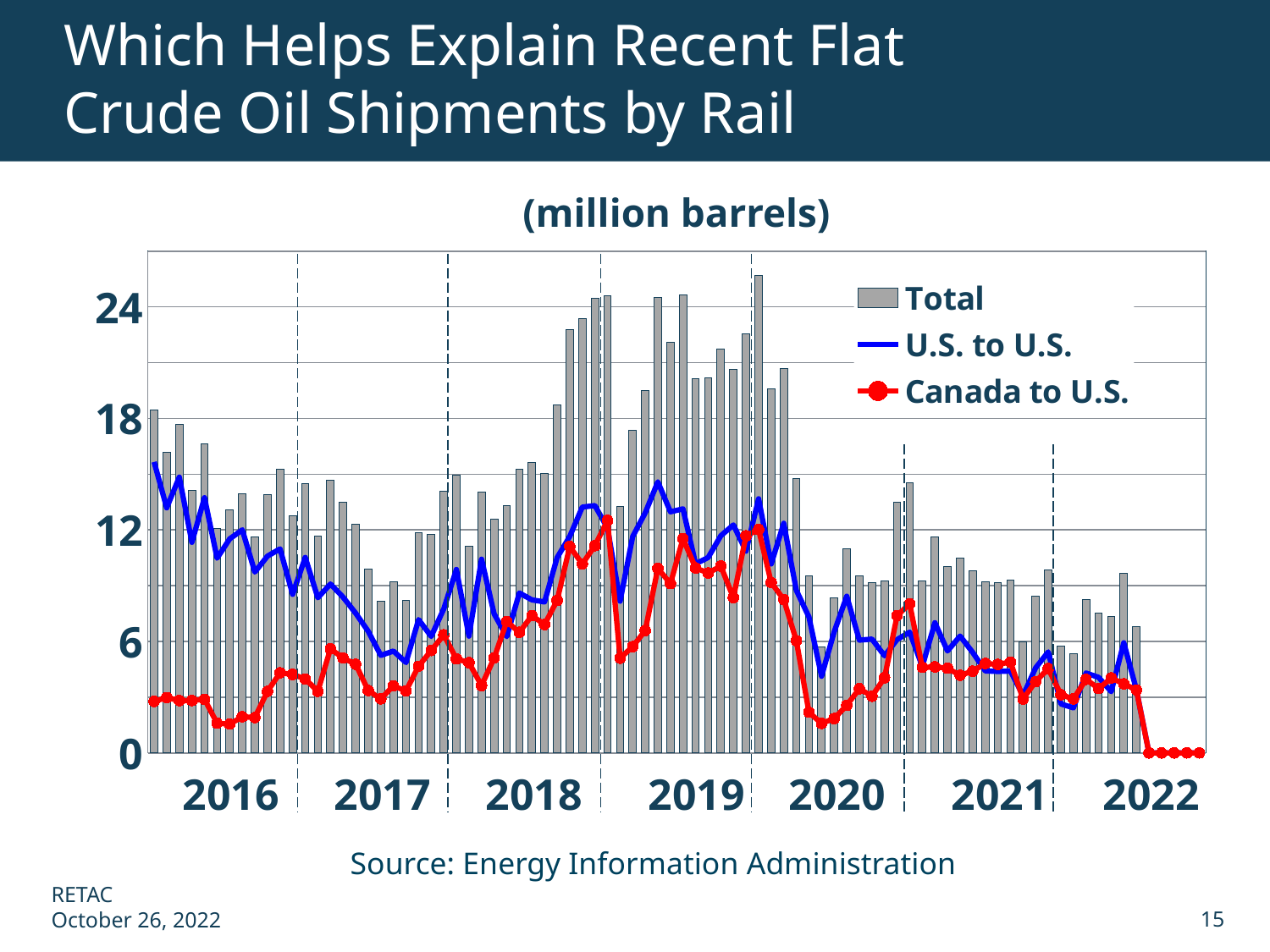
In which year does the tallest Total bar occur? 2020 Is the first U.S. to U.S. value in 2016 greater or less than 12? greater What kind of chart is shown on the slide? A bar chart with two line series overlaid What unit is given in the chart title? million barrels How many series does the legend list? 3 Do the Total bars rise or fall from their 2019 peak to 2022? fall At the start of 2016, which is larger: U.S. to U.S. or Canada to U.S.? U.S. to U.S. In which year does the Canada to U.S. series reach its lowest value? 2022 Is the tallest Total bar greater or less than 24? greater Is the first Canada to U.S. value in 2016 greater or less than 6? less How many years are labeled on the x axis? 7 Which series is plotted as bars? Total